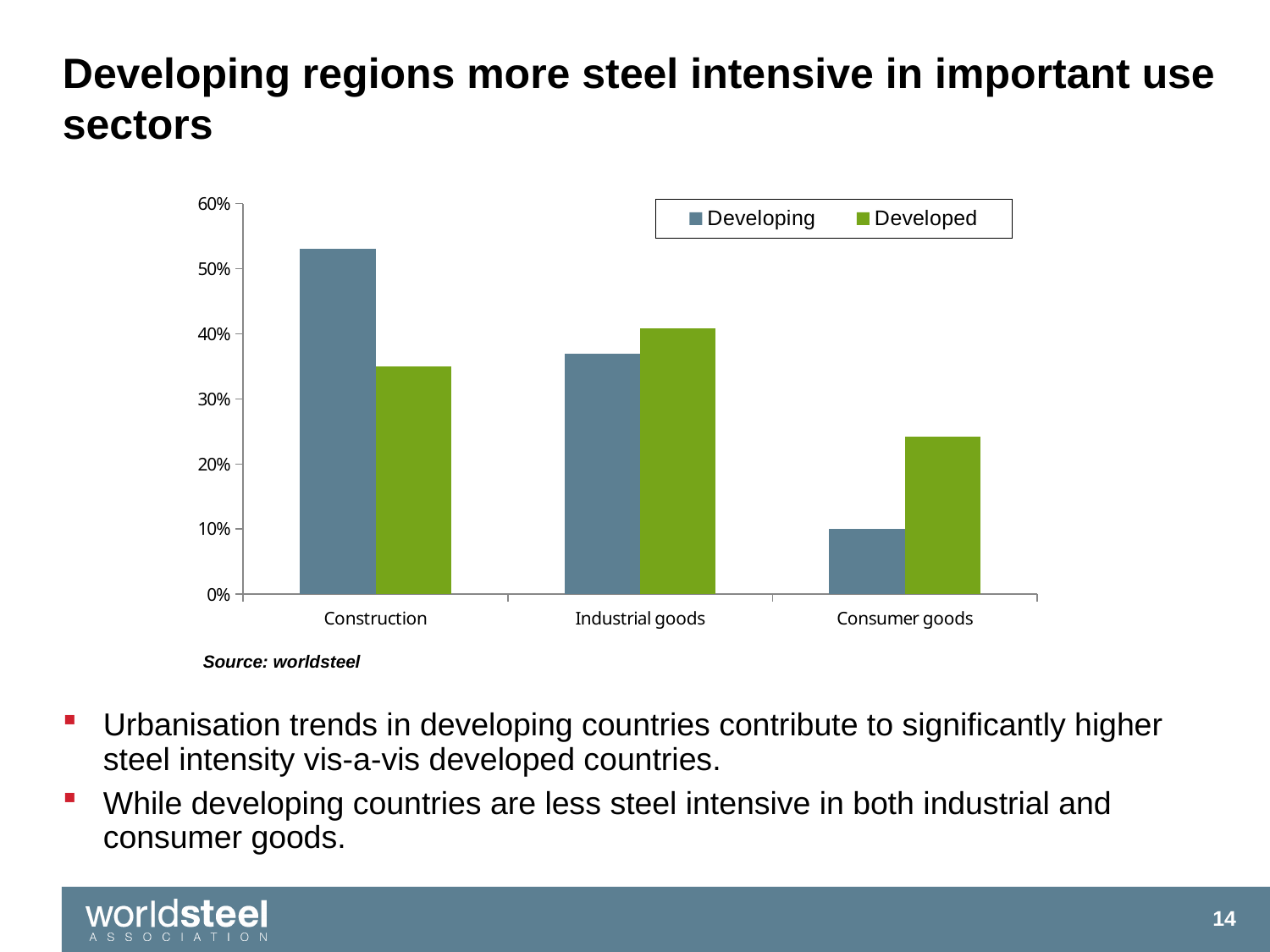
Is the Developing value for Construction greater or less than 50%? greater Which category has the lowest value for the Developed series? Consumer goods For Construction, which series has the larger value, Developing or Developed? Developing Do the Developing series values rise or fall from Construction to Consumer goods? fall What kind of chart is shown on the slide? bar chart Is the Developed value for Construction greater or less than 40%? less Which category has the highest value for the Developing series? Construction Is the Developed value for Consumer goods greater or less than 20%? greater For Consumer goods, which series has the larger value, Developing or Developed? Developed How many series does the legend list? 2 How many categories are shown on the x axis? 3